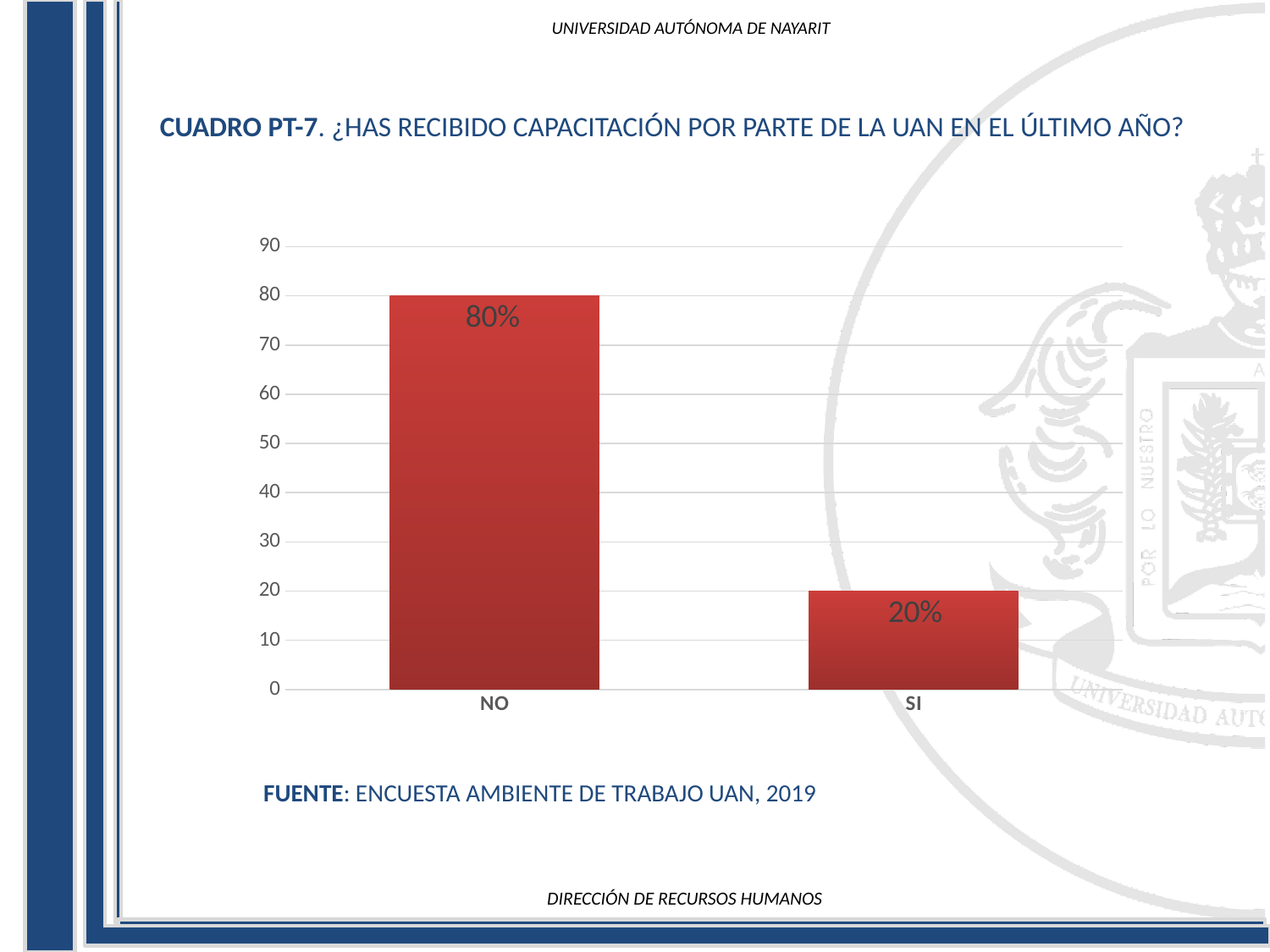
Which category has the highest value? NO What colour are the bars in the chart? red Which is larger, the value for NO or the value for SI? NO What kind of chart is shown on the slide? bar chart Is the value for NO greater or less than 50? greater What is the source cited below the chart? ENCUESTA AMBIENTE DE TRABAJO UAN, 2019 What is the difference between the values for NO and SI? 60% What is the value for NO? 80% What is the value for SI? 20% How many categories are shown on the x axis? 2 Which category has the lowest value? SI Is the value for SI greater or less than 30? less